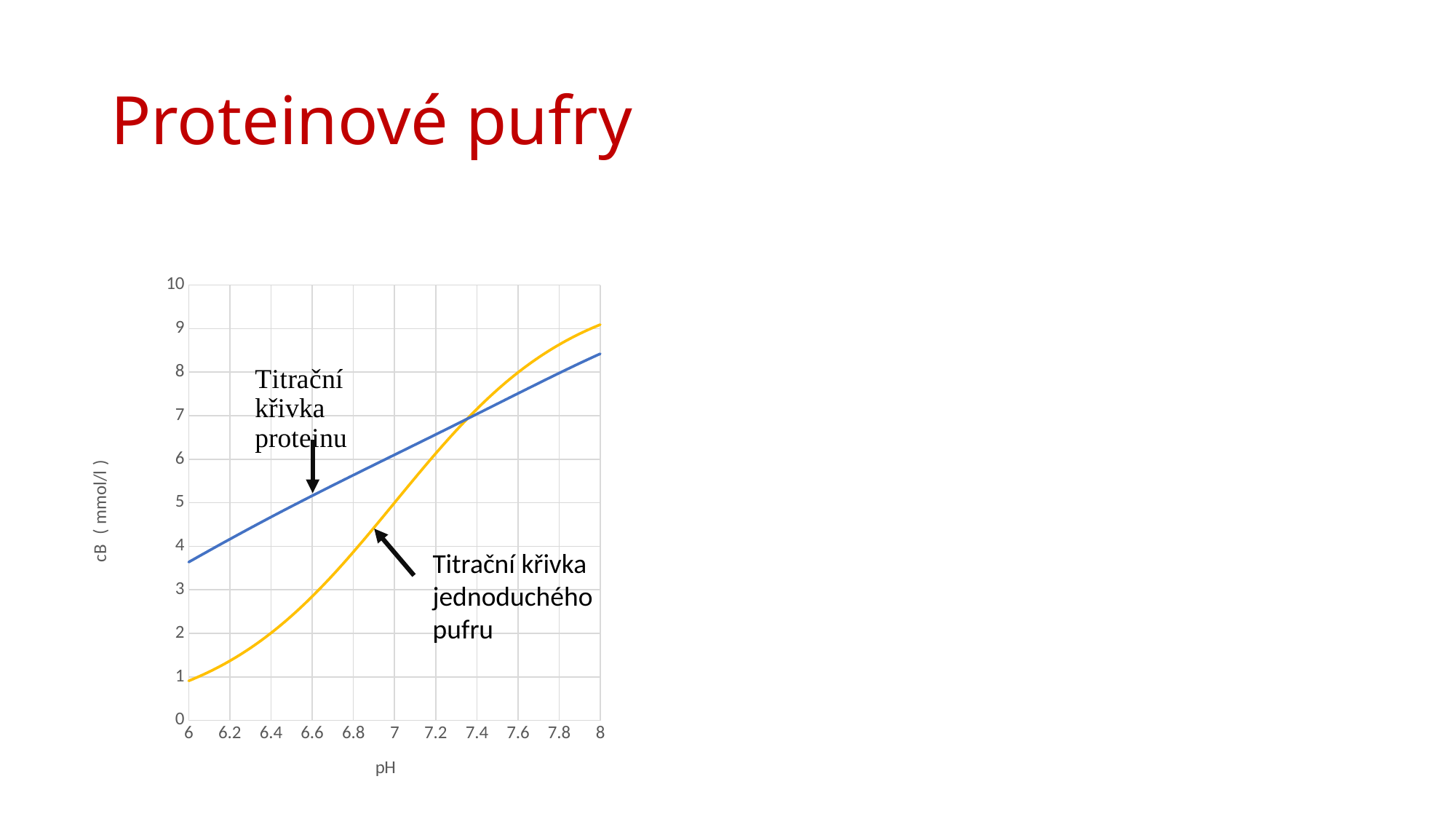
Does the curve labelled 'Titrační křivka jednoduchého pufru' rise or fall as pH increases? rise Is the value of 'Titrační křivka proteinu' at pH 6 greater or less than 3? greater At pH 6, which curve has the higher value: 'Titrační křivka proteinu' or 'Titrační křivka jednoduchého pufru'? Titrační křivka proteinu Does the curve labelled 'Titrační křivka proteinu' rise or fall as pH increases? rise Is the value of 'Titrační křivka proteinu' at pH 8 greater or less than 8? greater What is the label of the y axis? cB ( mmol/l ) What is the label of the x axis? pH What kind of chart is shown on the slide? line chart How many curves are plotted on the chart? 2 At pH 8, which curve has the higher value: 'Titrační křivka proteinu' or 'Titrační křivka jednoduchého pufru'? Titrační křivka jednoduchého pufru Is the value of 'Titrační křivka jednoduchého pufru' at pH 6 greater or less than 2? less